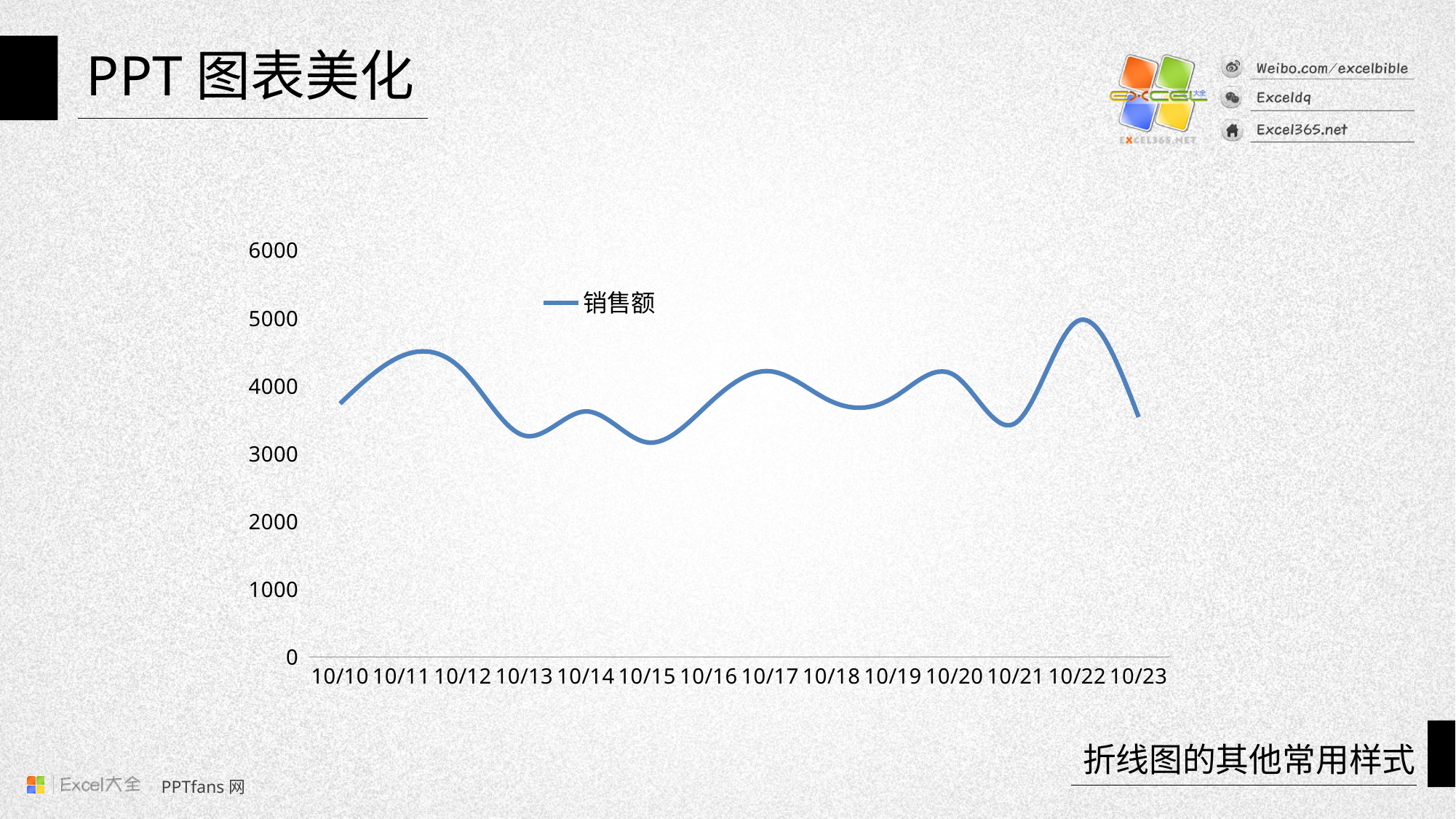
What is the highest value shown on the y axis? 6000 Is the value for 10/13 greater or less than 3000? greater Is the value for 10/22 greater or less than 4000? greater What is the name of the series shown in the legend? 销售额 Does the value rise or fall from 10/22 to 10/23? fall Which is larger, the value for 10/22 or the value for 10/10? 10/22 Is the value for 10/15 greater or less than 4000? less On which date is the value for 销售额 highest? 10/22 How many series does the legend list? 1 What kind of chart is shown on the slide? line chart How many dates are shown on the x axis? 14